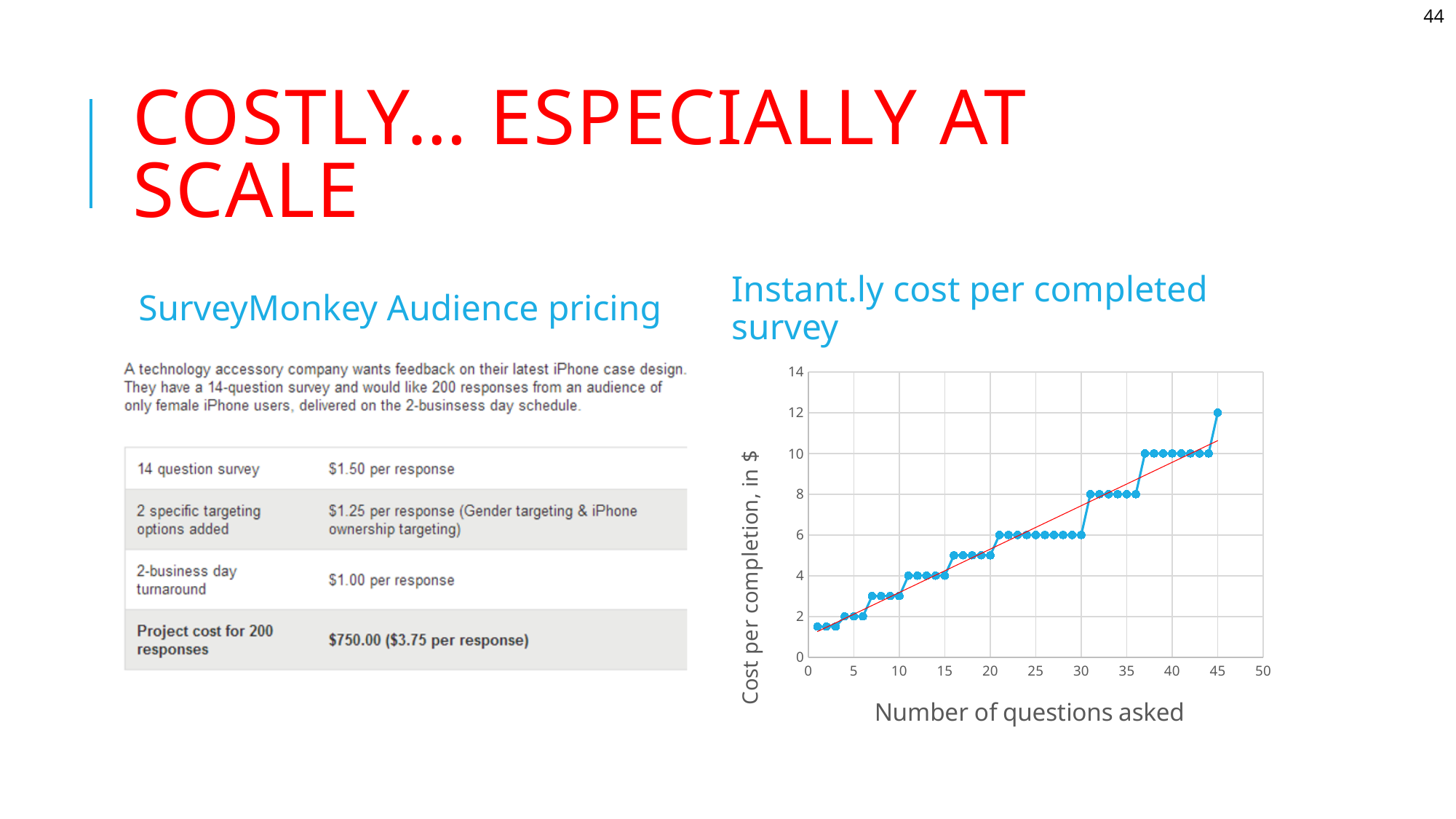
In the "Instant.ly cost per completed survey" chart, which has a higher cost per completion: 20 questions asked or 40 questions asked? 40 questions asked In the "Instant.ly cost per completed survey" chart, what is the cost per completion at 35 questions asked? 8 In the "Instant.ly cost per completed survey" chart, what is the cost per completion at 40 questions asked? 10 In the "Instant.ly cost per completed survey" chart, what is the cost per completion at 25 questions asked? 6 In the "Instant.ly cost per completed survey" chart, is the cost per completion at 30 questions asked greater or less than 8? less In the "Instant.ly cost per completed survey" chart, what is the difference in cost per completion between 45 questions asked and 40 questions asked? 2 What kind of chart is the "Instant.ly cost per completed survey" chart? line chart In the "Instant.ly cost per completed survey" chart, is the cost per completion at 2 questions asked greater or less than 2? less In the "Instant.ly cost per completed survey" chart, does the cost per completion rise or fall as the number of questions asked increases? rise In the "Instant.ly cost per completed survey" chart, at how many questions asked is the cost per completion highest? 45 What is the label of the x axis in the "Instant.ly cost per completed survey" chart? Number of questions asked In the "Instant.ly cost per completed survey" chart, what is the cost per completion at 45 questions asked? 12